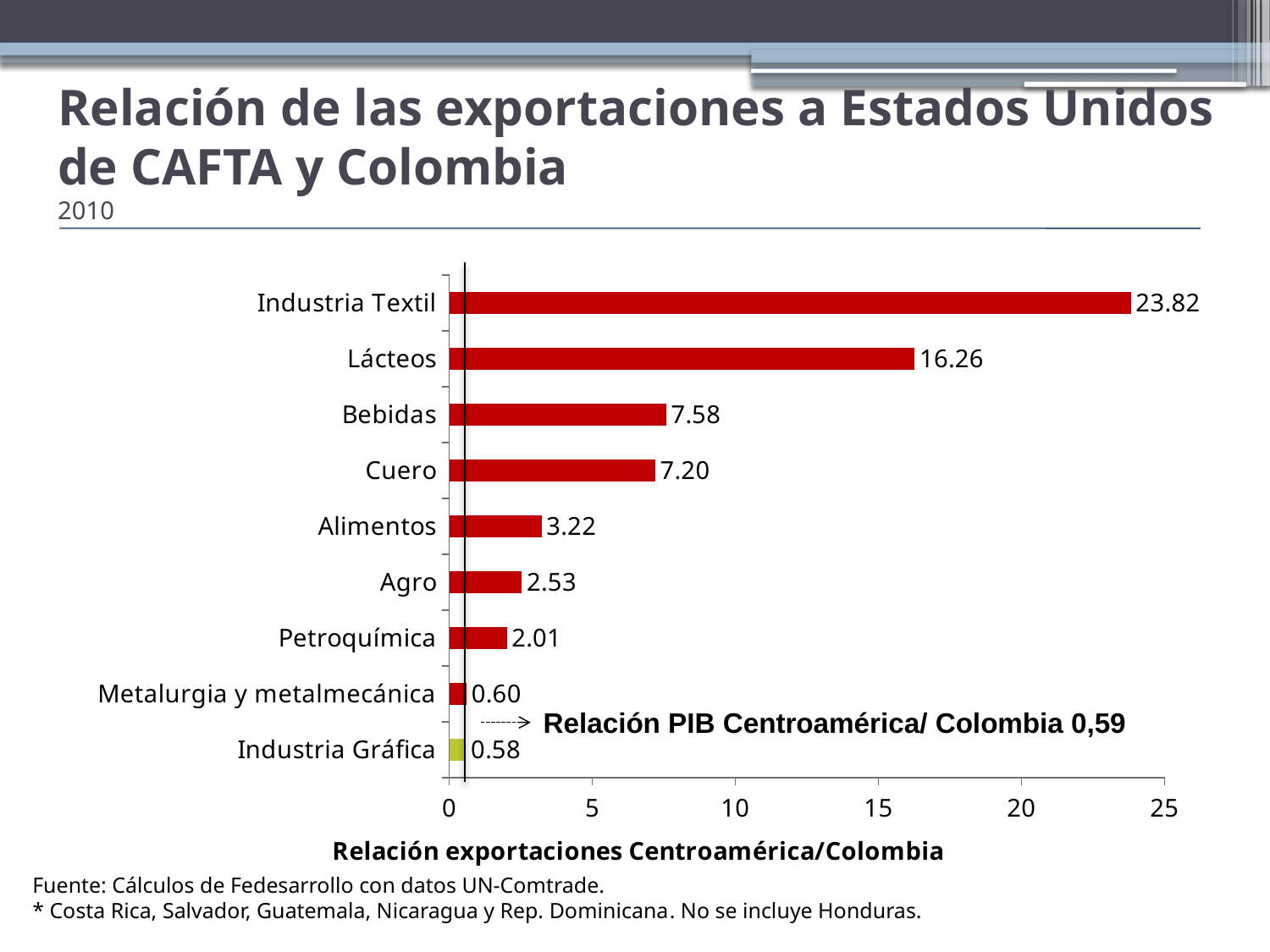
What is the x-axis title of the chart? Relación exportaciones Centroamérica/Colombia Which category has the highest value? Industria Textil How many categories are shown in the chart? 9 What is the value for Lácteos? 16.26 What kind of chart is shown on the slide? Bar chart Which is larger, the value for Alimentos or the value for Agro? Alimentos What is the value for Industria Textil? 23.82 What is the difference between the values for Industria Textil and Lácteos? 7.56 Which category has the lowest value? Industria Gráfica What is the value for Cuero? 7.20 What is the difference between the values for Bebidas and Cuero? 0.38 What is the value for Petroquímica? 2.01